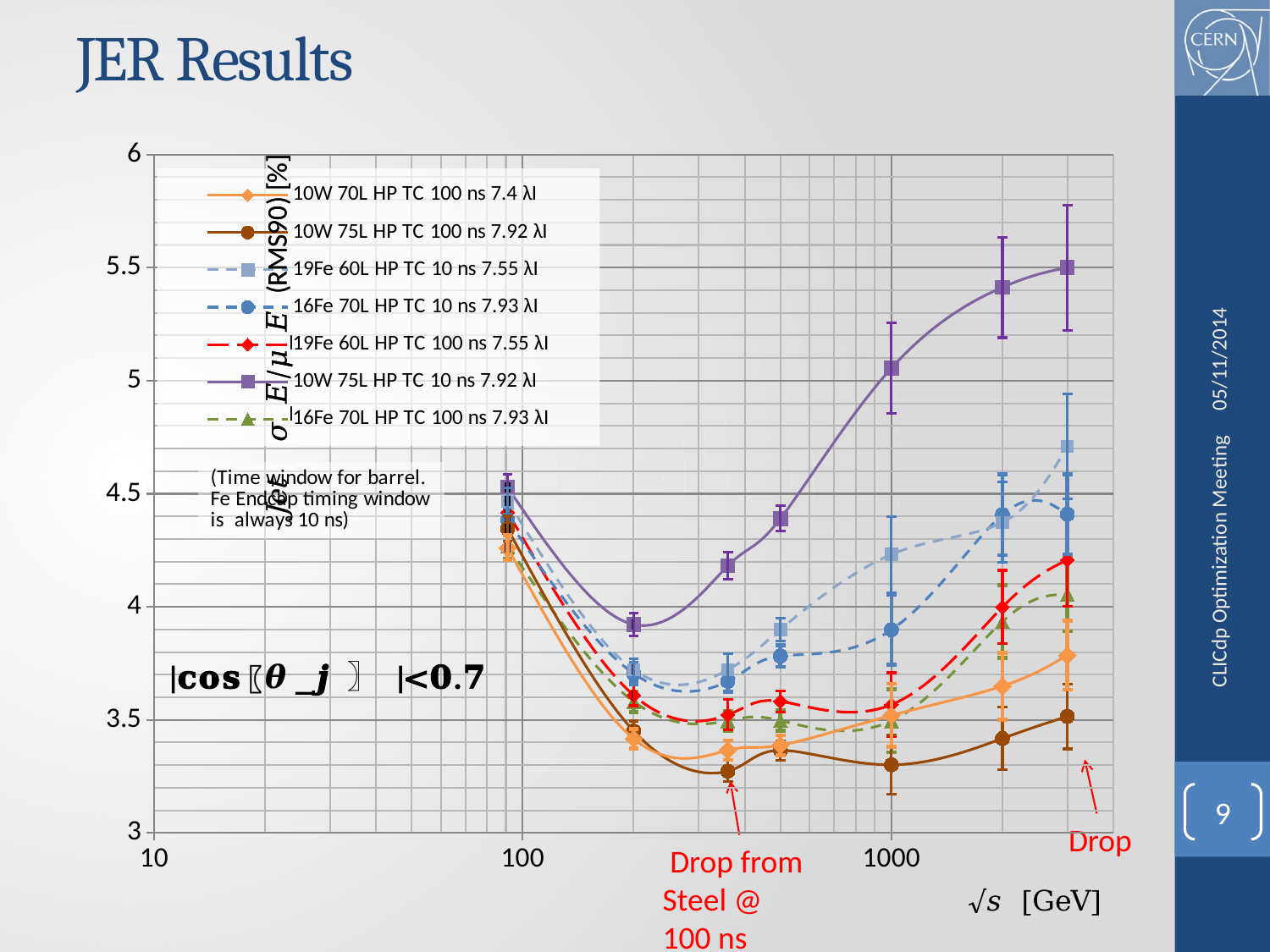
Is the value for 10W 75L HP TC 10 ns 7.92 λI at 3000 GeV greater or less than 5? greater Is the value for 10W 75L HP TC 10 ns 7.92 λI at 200 GeV greater or less than 4? less How many series does the legend list? 7 What does the red annotation near the bottom of the chart say? Drop from Steel @ 100 ns Which series has the highest value at 3000 GeV? 10W 75L HP TC 10 ns 7.92 λI Does the 10W 75L HP TC 10 ns 7.92 λI series rise or fall between 200 GeV and 3000 GeV? rise At 3000 GeV, which is larger: 10W 75L HP TC 10 ns 7.92 λI or 10W 75L HP TC 100 ns 7.92 λI? 10W 75L HP TC 10 ns 7.92 λI Is the value for 19Fe 60L HP TC 10 ns 7.55 λI at 1000 GeV greater or less than 4? greater What quantity is plotted on the x axis? √s [GeV] Which series has the lowest value at 3000 GeV? 10W 75L HP TC 100 ns 7.92 λI What kind of chart is shown on the slide? line chart